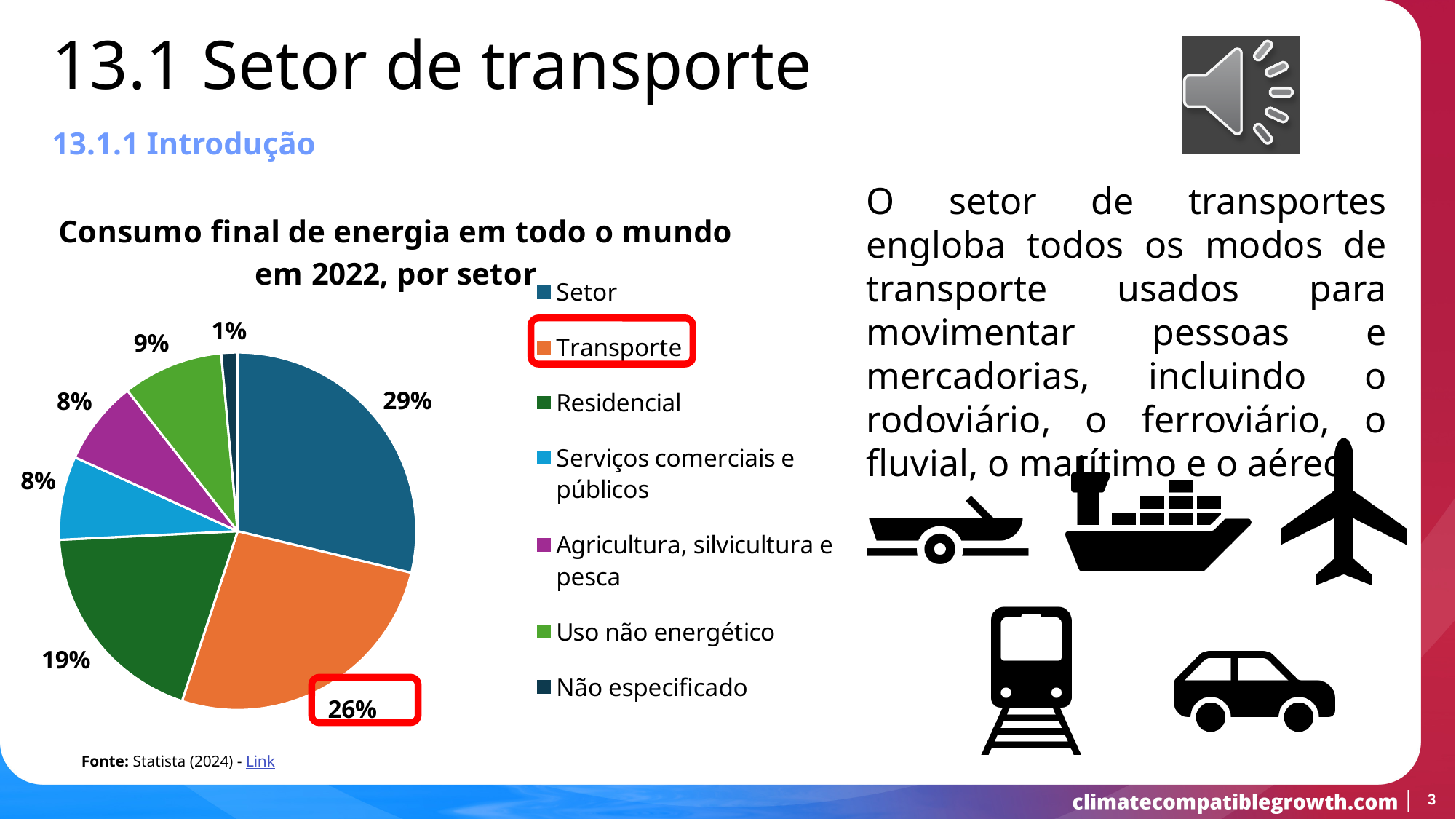
What type of chart is shown on the slide? Pie chart What is the value for Uso não energético? 9% How many categories does the pie chart legend list? 7 What is the difference in percentage points between the Setor slice and the Transporte slice? 3 What share of the pie does Transporte account for? 26% What share is shown for the legend entry Setor? 29% Which legend category has the largest slice of the pie? Setor Which category has the smallest slice of the pie? Não especificado What percentage is shown for Residencial? 19% What percentage is labelled for Não especificado? 1% Which is larger, the Residencial slice or the Uso não energético slice? Residencial What is the title of the chart? Consumo final de energia em todo o mundo em 2022, por setor